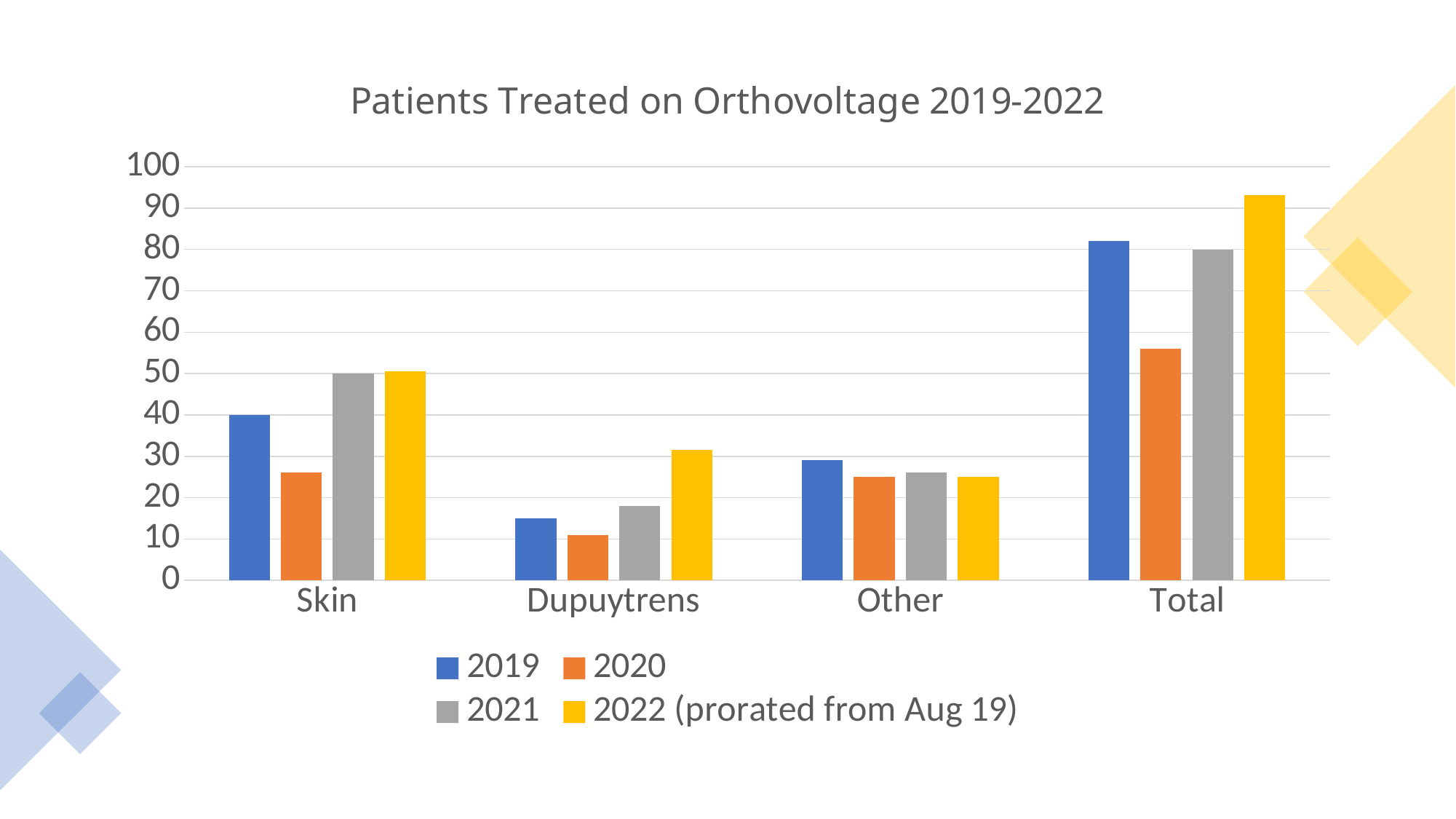
Is the value for Total in 2022 (prorated from Aug 19) greater or less than 90? greater What type of chart is shown on the slide? bar chart Which category has the highest value for 2022 (prorated from Aug 19)? Total How many series does the legend list? 4 What is the value for Skin in 2019? 40 Which year has the lowest value for Dupuytrens? 2020 How many categories are shown on the x axis? 4 What is the value for Total in 2021? 80 For Skin, which is larger: the 2019 value or the 2020 value? 2019 What is the title of the chart? Patients Treated on Orthovoltage 2019-2022 What is the value for Skin in 2021? 50 Is the value for Dupuytrens in 2020 greater or less than 20? less